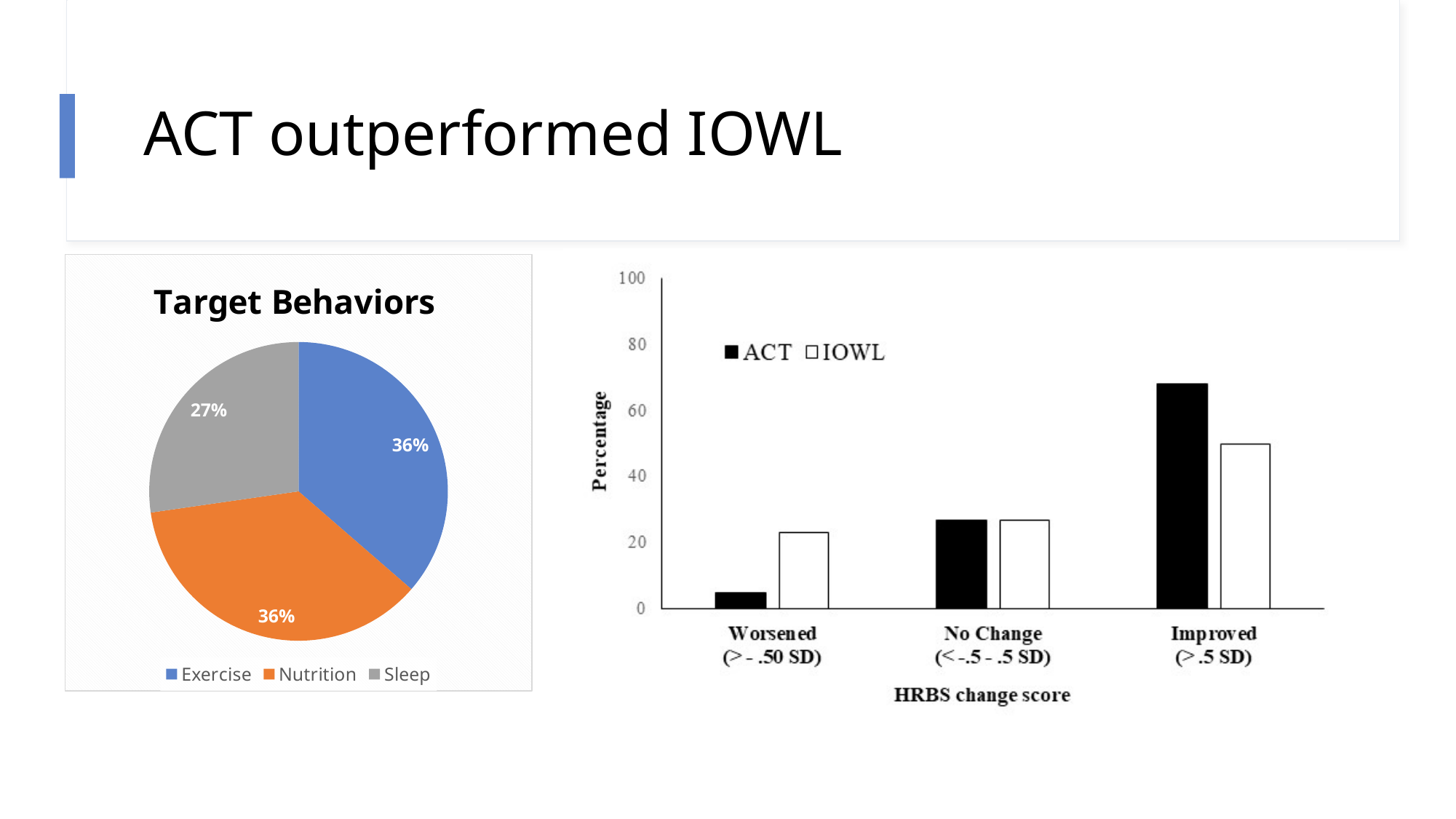
In the Target Behaviors pie chart, which category has the smallest share? Sleep In the Target Behaviors pie chart, how many categories are shown? 3 In the Target Behaviors pie chart, what is the difference between the Nutrition share and the Sleep share? 9% In the HRBS change score bar chart on the right, is the ACT value for Improved greater or less than 60? greater What kind of chart is the chart on the right showing HRBS change score? Bar chart In the HRBS change score bar chart on the right, how many categories are shown on the x axis? 3 In the HRBS change score bar chart on the right, how many series does the legend list? 2 What kind of chart is the Target Behaviors chart on the left? Pie chart In the HRBS change score bar chart on the right, which is larger for the Improved category, ACT or IOWL? ACT In the HRBS change score bar chart on the right, is the ACT value for Worsened greater or less than 20? less In the Target Behaviors pie chart, what percentage is shown for Sleep? 27% In the Target Behaviors pie chart, what percentage is shown for Exercise? 36%